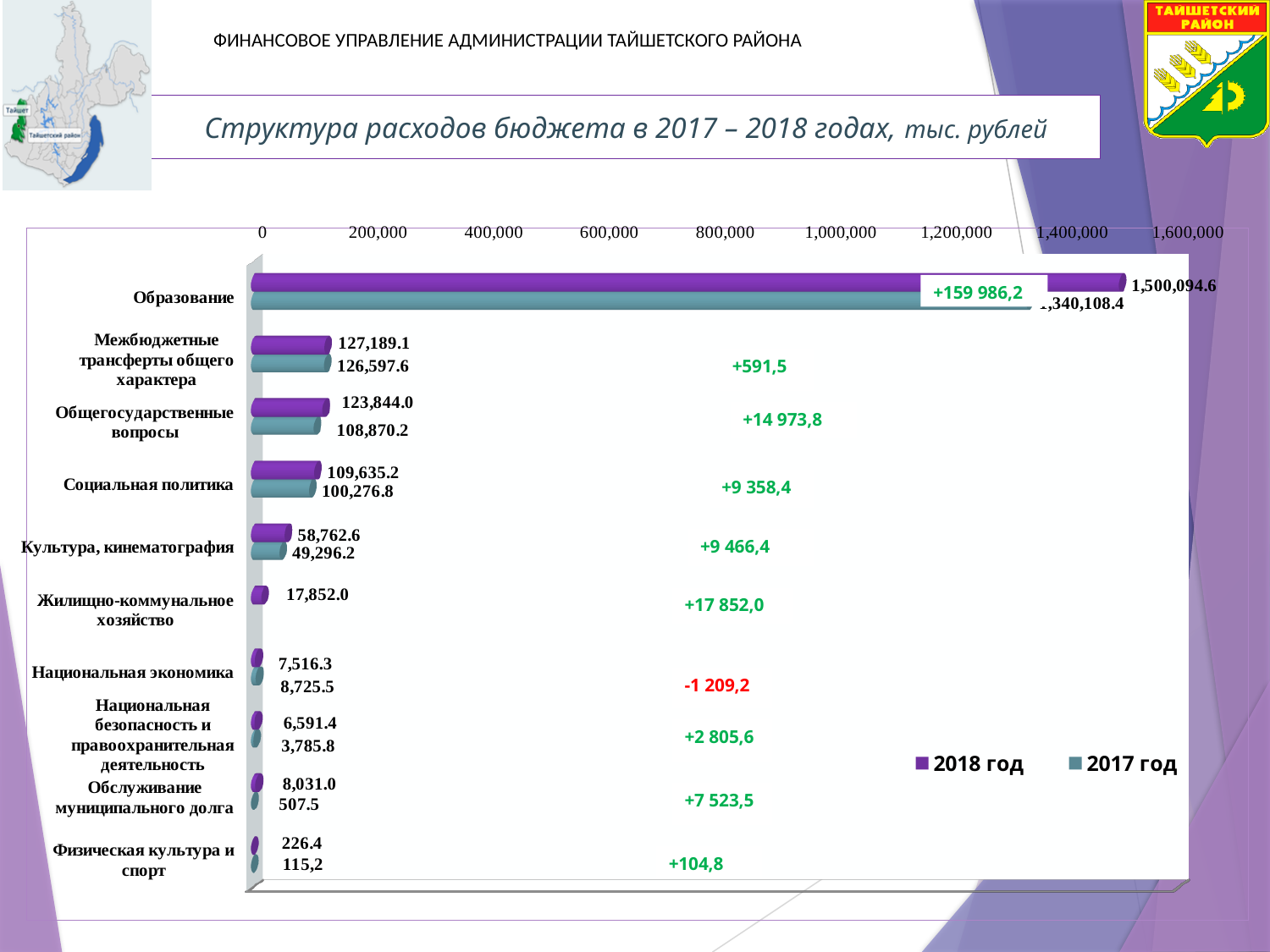
What is the 2017 год value for Социальная политика? 100,276.8 Which is larger for Национальная экономика, the 2018 год value or the 2017 год value? 2017 год What is the 2018 год value for Обслуживание муниципального долга? 8,031.0 How many expenditure categories are shown on the chart? 10 Which series is shown in purple in the legend? 2018 год Which category has the highest 2018 год value? Образование What is the difference between the 2018 год and 2017 год values for Общегосударственные вопросы? 14,973.8 What is the 2017 год value for Культура, кинематография? 49,296.2 How many series does the legend list? 2 What kind of chart is shown on the slide? bar chart Which category has the lowest 2017 год value? Физическая культура и спорт What is the 2018 год value for Образование? 1,500,094.6